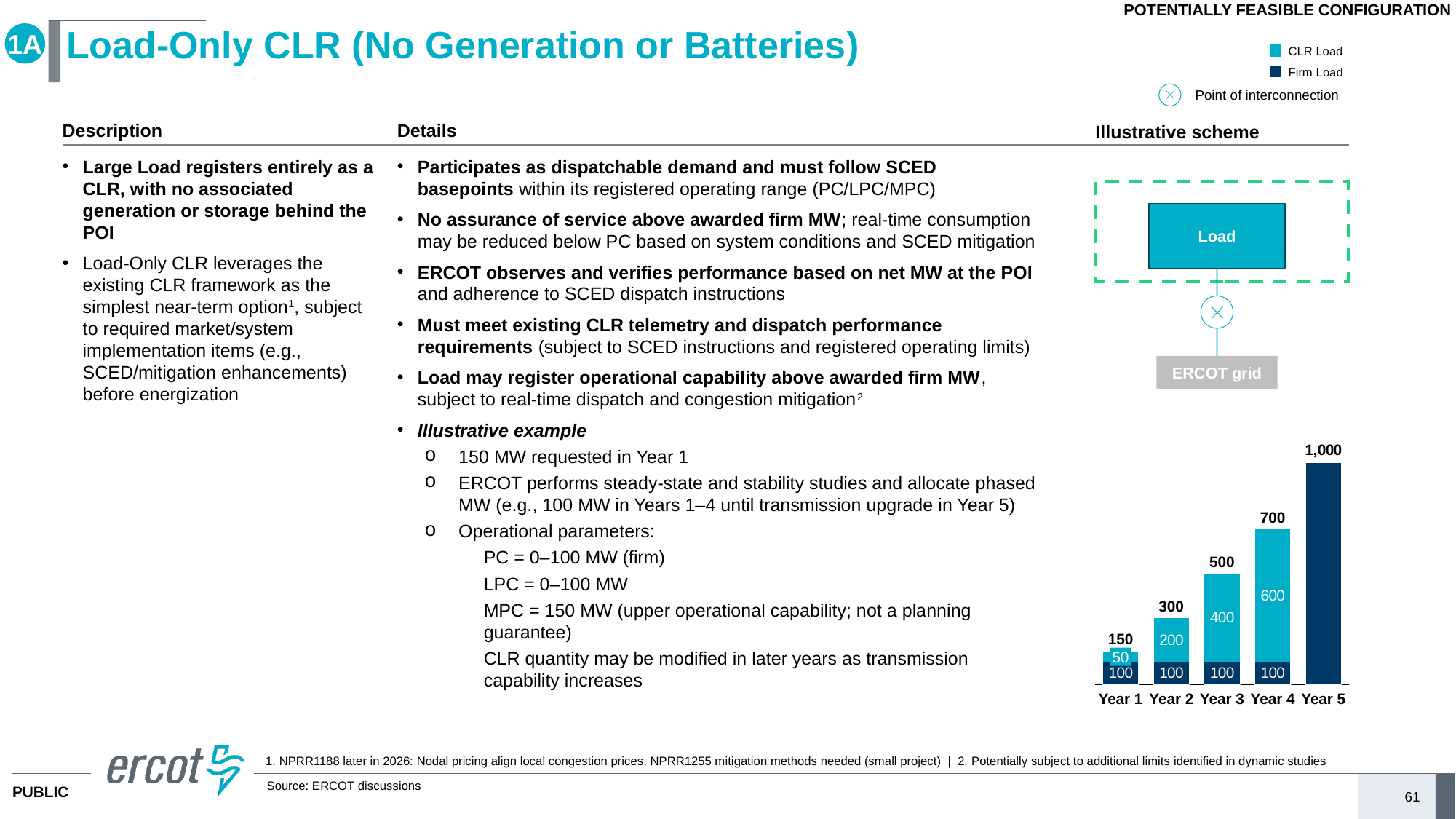
Which year has the lowest total value? Year 1 What is the difference between the total for Year 5 and the total for Year 4? 300 What kind of chart is shown on the slide? Stacked bar chart Which is larger, the CLR Load value for Year 3 or the CLR Load value for Year 4? Year 4 What is the Firm Load value for Year 4? 100 Which year has the highest total value? Year 5 Do the total values rise or fall from Year 1 to Year 5? Rise What is the CLR Load value for Year 1? 50 What is the total value shown above the bar for Year 3? 500 How many years are shown on the x axis of the chart? 5 How many series does the legend list? 2 What is the CLR Load value for Year 2? 200